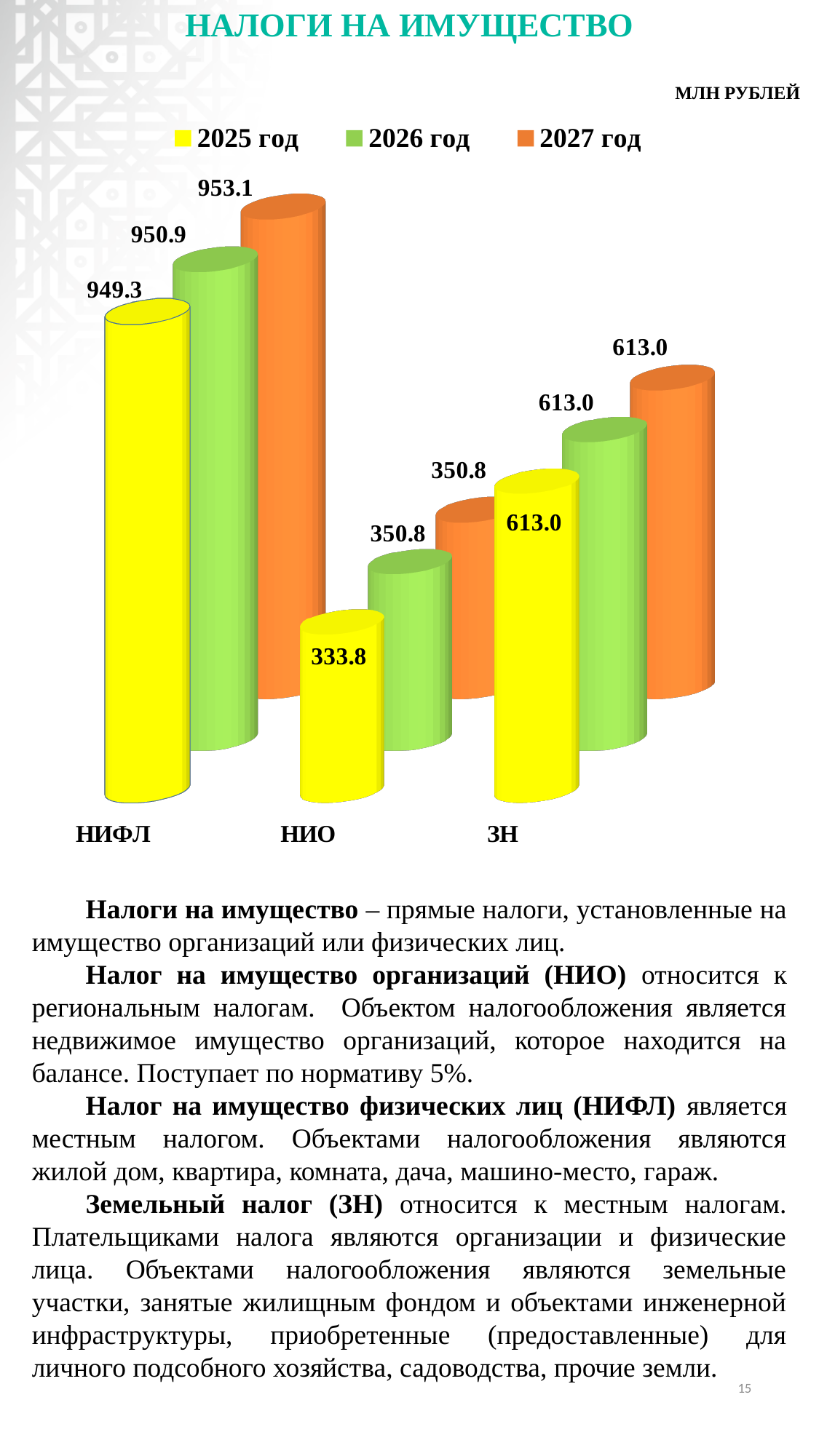
Which is larger: the 2025 год value for ЗН or the 2027 год value for НИО? 2025 год value for ЗН What is the value for НИО in 2025 год? 333.8 What is the difference between the 2027 год and 2025 год values for НИФЛ? 3.8 How many series does the legend list? 3 What is the difference between the 2026 год and 2025 год values for НИО? 17.0 Which category has the highest value in 2026 год? НИФЛ Which category has the lowest value in 2025 год? НИО What is the value for НИФЛ in 2025 год? 949.3 What kind of chart is shown on the slide? Bar chart What is the value for ЗН in 2027 год? 613.0 What is the value for НИФЛ in 2027 год? 953.1 How many categories are shown on the x axis? 3